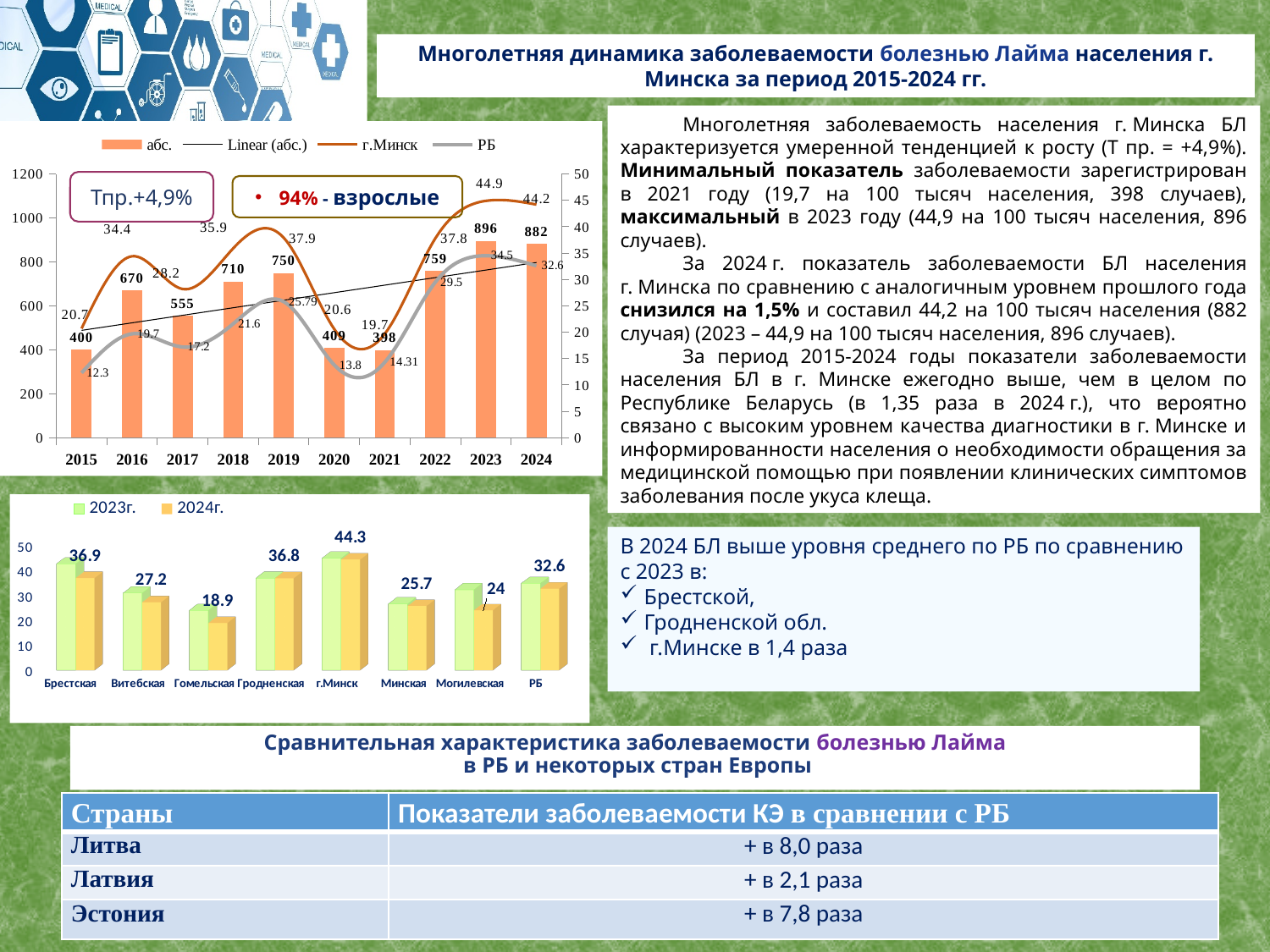
In the top chart, which year has the highest абс. bar? 2023 In the top chart, what is the value of the г.Минск line for 2015? 20.7 In the top chart, what is the value of the абс. bar for 2023? 896 In the top chart, how many years are shown on the x axis? 10 In the bottom chart, how many series does the legend list? 2 In the top chart, what is the value of the РБ line for 2024? 32.6 In the top chart, which year has the lowest абс. bar? 2021 What kind of chart is the top chart? Combined bar and line chart In the bottom chart, how many categories are shown on the x axis? 8 In the top chart, how many series does the legend list? 4 In the top chart, what is the difference between the абс. values for 2023 and 2024? 14 In the top chart, which year has the larger абс. value, 2018 or 2019? 2019